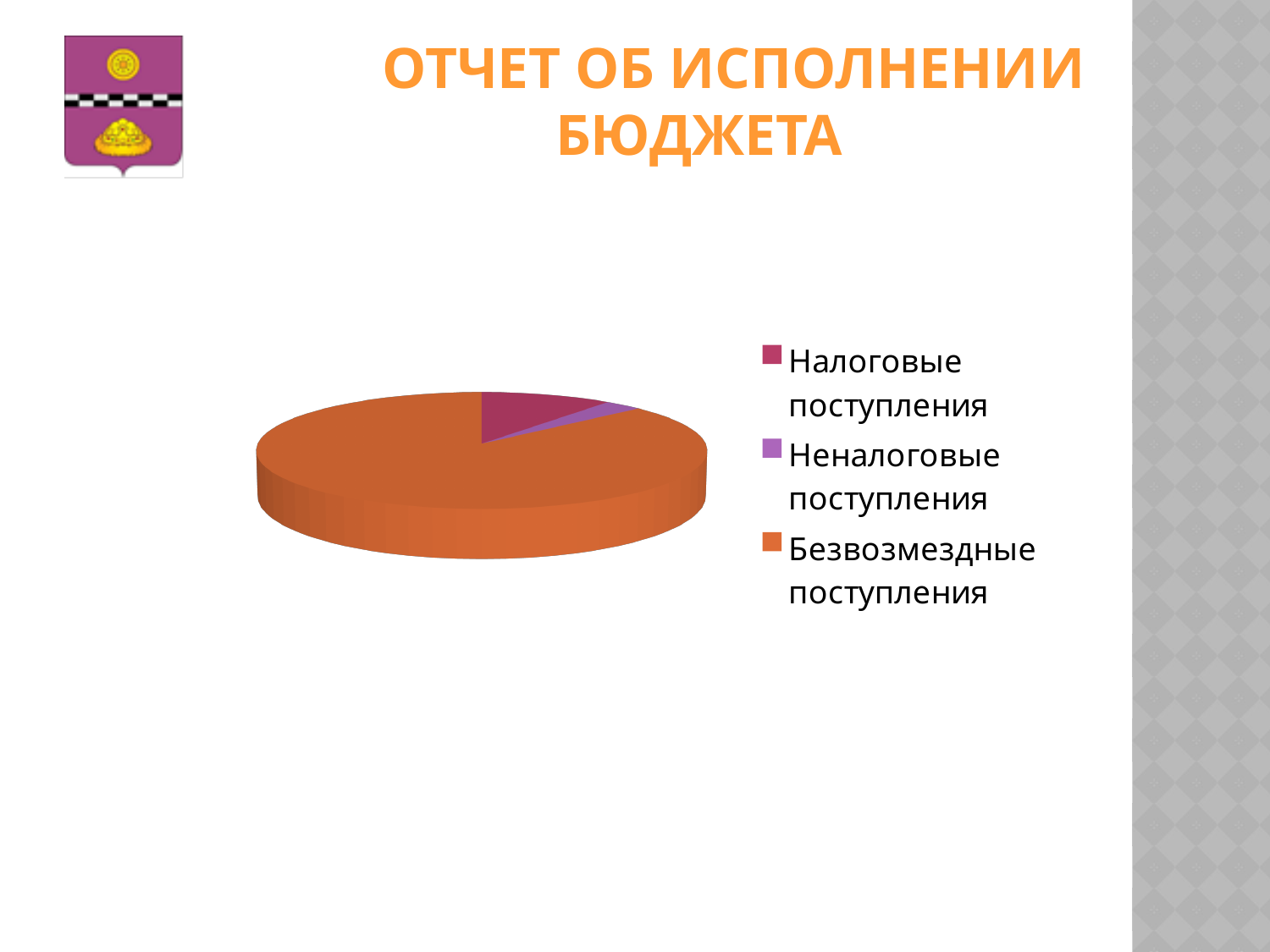
Which category has the smallest slice in the pie chart? Неналоговые поступления Which slice is larger: Налоговые поступления or Неналоговые поступления? Налоговые поступления Which slice is larger: Безвозмездные поступления or Налоговые поступления? Безвозмездные поступления What is the title of the slide containing the pie chart? ОТЧЕТ ОБ ИСПОЛНЕНИИ БЮДЖЕТА What kind of chart is shown on the slide? Pie chart How many entries does the legend of the pie chart list? 3 What colour is the slice for Безвозмездные поступления? Orange Which category has the largest slice in the pie chart? Безвозмездные поступления How many categories does the pie chart show? 3